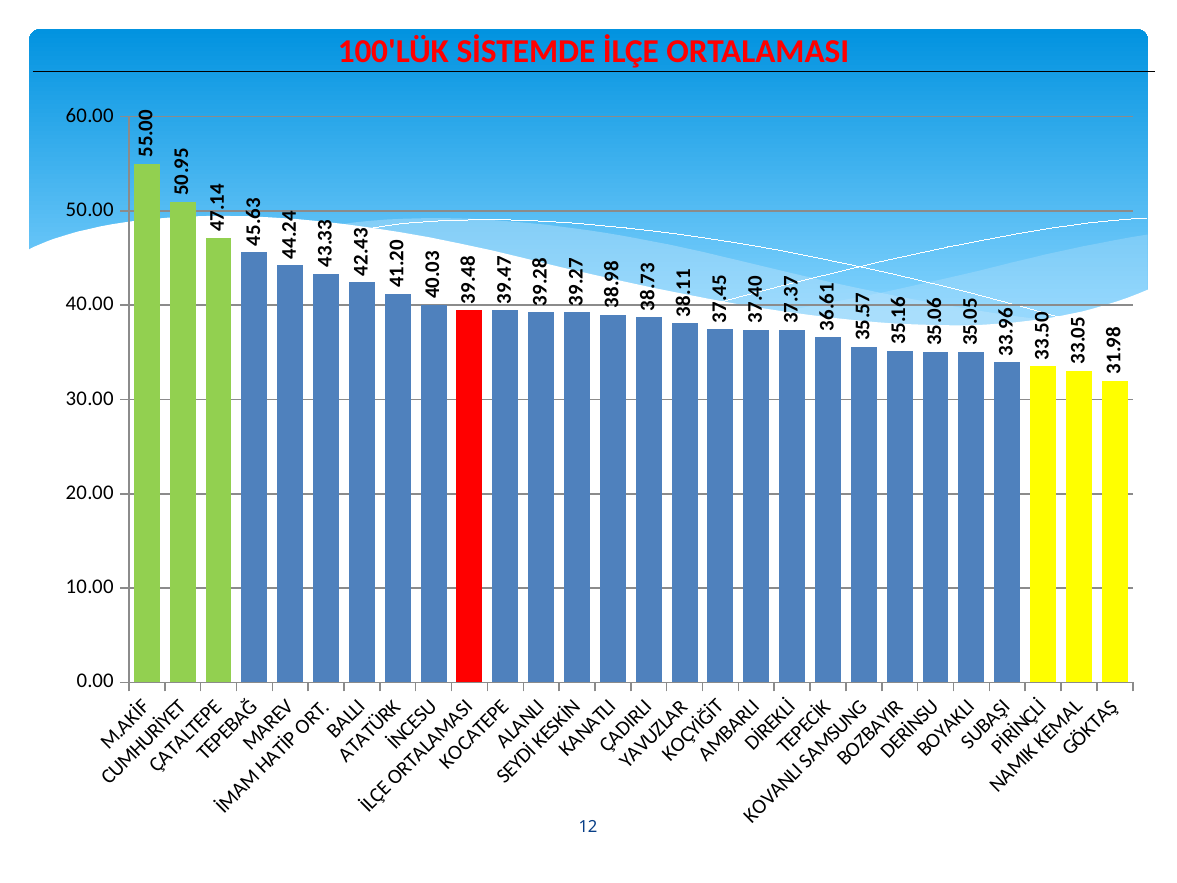
What is the difference between the values for TEPEBAĞ and GÖKTAŞ? 13.65 What is the value for GÖKTAŞ? 31.98 What is the value for M.AKİF? 55.00 Which is larger, the value for ÇATALTEPE or the value for TEPECİK? ÇATALTEPE Which category has the lowest value? GÖKTAŞ What is the value for KOVANLI SAMSUNG? 35.57 What kind of chart is shown on the slide? Bar chart What is the difference between the values for M.AKİF and CUMHURİYET? 4.05 Do the values rise or fall from left to right along the x axis? Fall Which category has the highest value? M.AKİF How many bars are shown in the chart? 28 What is the value for İLÇE ORTALAMASI? 39.48